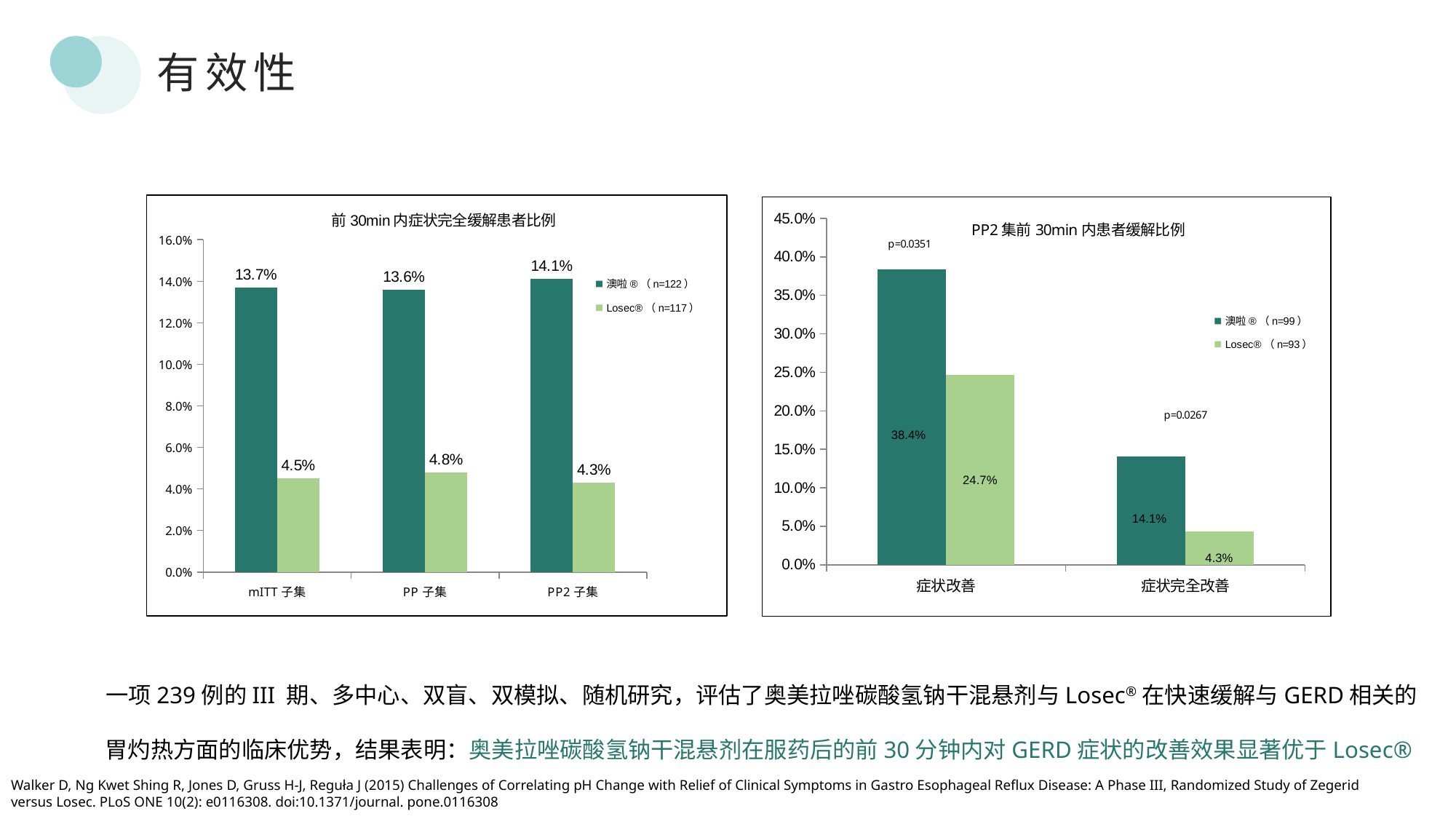
In the right chart titled PP2 集前 30min 内患者缓解比例, what is the value for Losec® in the 症状完全改善 category? 4.3% In the left chart titled 前 30min 内症状完全缓解患者比例, how many series does the legend list? 2 In the left chart titled 前 30min 内症状完全缓解患者比例, which category has the lowest Losec® value? PP2 子集 In the right chart titled PP2 集前 30min 内患者缓解比例, which is larger: the Losec® value for 症状改善 or the 澳啦® value for 症状完全改善? Losec® value for 症状改善 In the left chart titled 前 30min 内症状完全缓解患者比例, what is the value for Losec® in the PP 子集 category? 4.8% In the right chart titled PP2 集前 30min 内患者缓解比例, what is the difference between the 澳啦® and Losec® values in the 症状改善 category? 13.7% In the right chart titled PP2 集前 30min 内患者缓解比例, what is the value for 澳啦® in the 症状改善 category? 38.4% In the left chart titled 前 30min 内症状完全缓解患者比例, what is the difference between the 澳啦® and Losec® values in the mITT 子集 category? 9.2% In the left chart titled 前 30min 内症状完全缓解患者比例, how many categories are shown on the x axis? 3 In the right chart titled PP2 集前 30min 内患者缓解比例, what p-value is printed above the 症状完全改善 bars? p=0.0267 What kind of chart is the right chart titled PP2 集前 30min 内患者缓解比例? Bar chart In the left chart titled 前 30min 内症状完全缓解患者比例, what is the value for 澳啦® in the PP2 子集 category? 14.1%